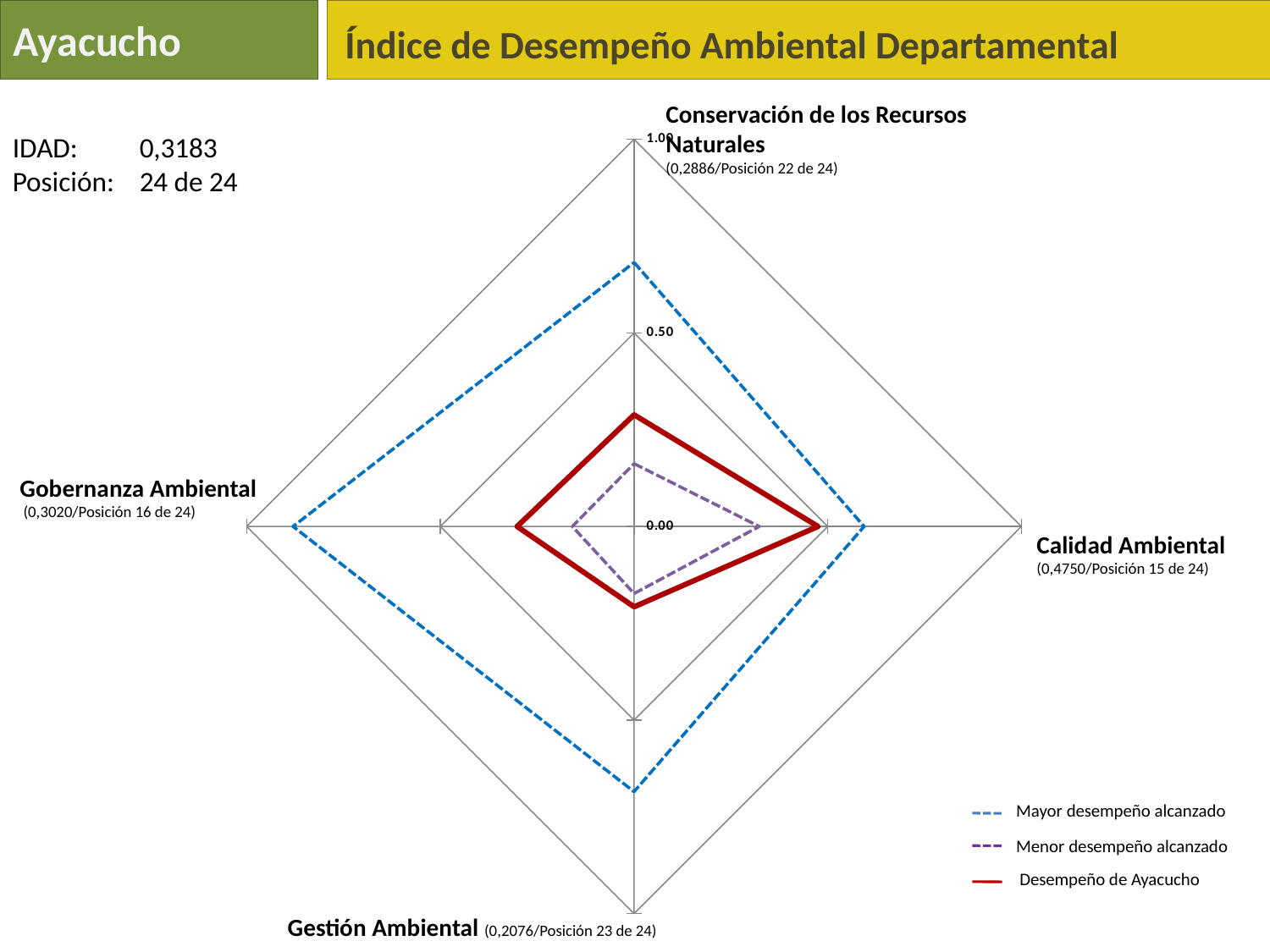
What is Ayacucho's value for Gobernanza Ambiental? 0,3020 On which axis does Ayacucho have its highest value? Calidad Ambiental What is Ayacucho's value for Gestión Ambiental? 0,2076 Is Ayacucho's value for Calidad Ambiental greater or less than 0.50? less How many axes (categories) does the radar chart have? 4 Which is larger for Ayacucho: Gobernanza Ambiental or Conservación de los Recursos Naturales? Gobernanza Ambiental What is Ayacucho's value for Conservación de los Recursos Naturales? 0,2886 How many series does the legend list? 3 On which axis does Ayacucho have its lowest value? Gestión Ambiental What kind of chart is shown on the slide? radar chart What is Ayacucho's value for Calidad Ambiental? 0,4750 Which series is drawn with a solid red line? Desempeño de Ayacucho